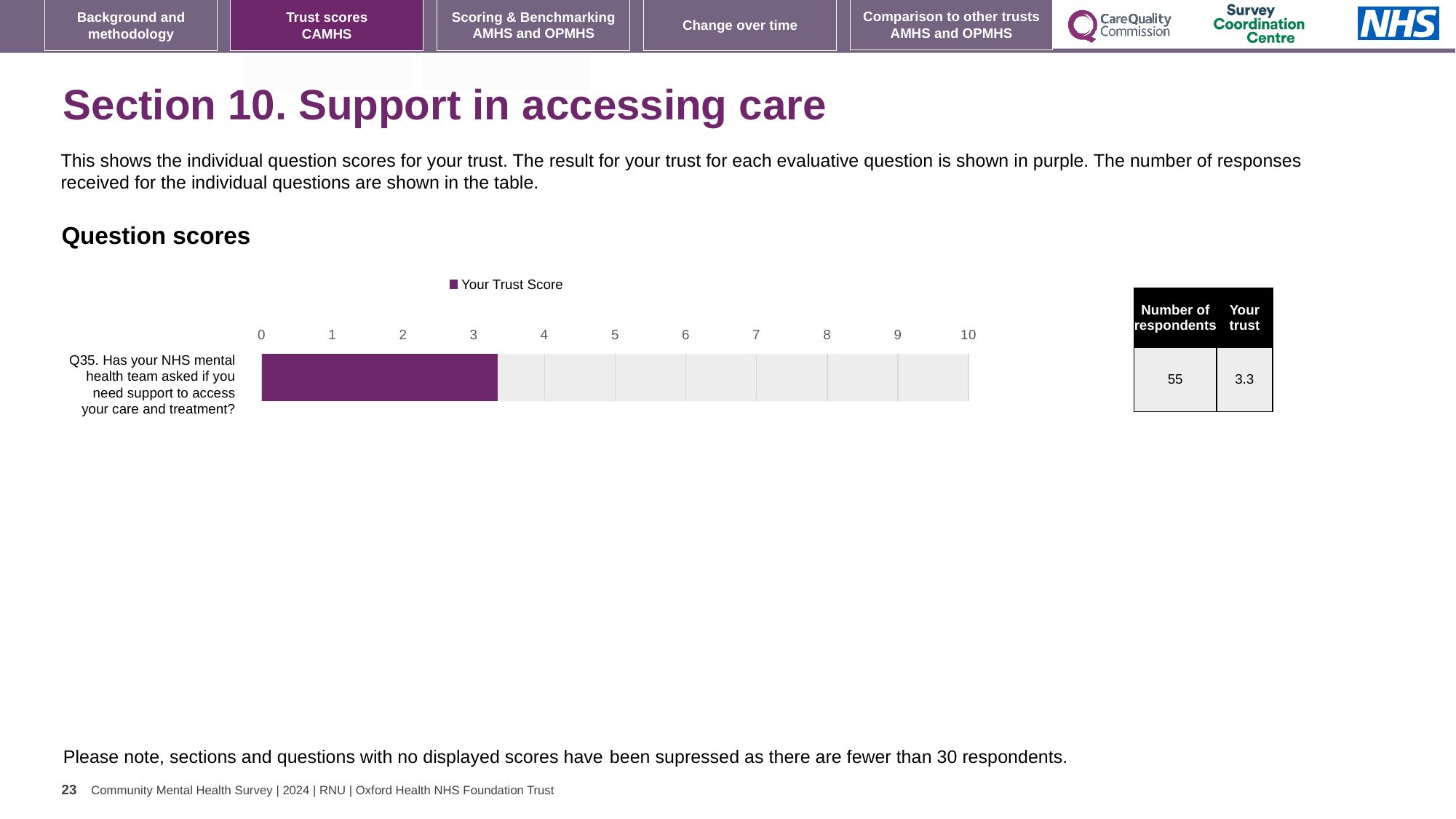
Which question is plotted in the Question scores chart? Q35. Has your NHS mental health team asked if you need support to access your care and treatment? What is the maximum value shown on the x axis of the Question scores chart? 10 What is the trust score for Q35 (Has your NHS mental team asked if you need support to access your care and treatment?) as shown in the table beside the chart? 3.3 What kind of chart is shown under the heading "Question scores"? bar chart How many questions (categories) are plotted in the Question scores chart? 1 Is the value for Q35 in the Question scores chart greater or less than 4? less Is the value for Q35 in the Question scores chart greater or less than 3? greater Is the value for Q35 in the Question scores chart greater or less than 5? less What is the name of the series shown in the legend of the Question scores chart? Your Trust Score How many series does the legend of the Question scores chart list? 1 How many respondents answered Q35 according to the table beside the chart? 55